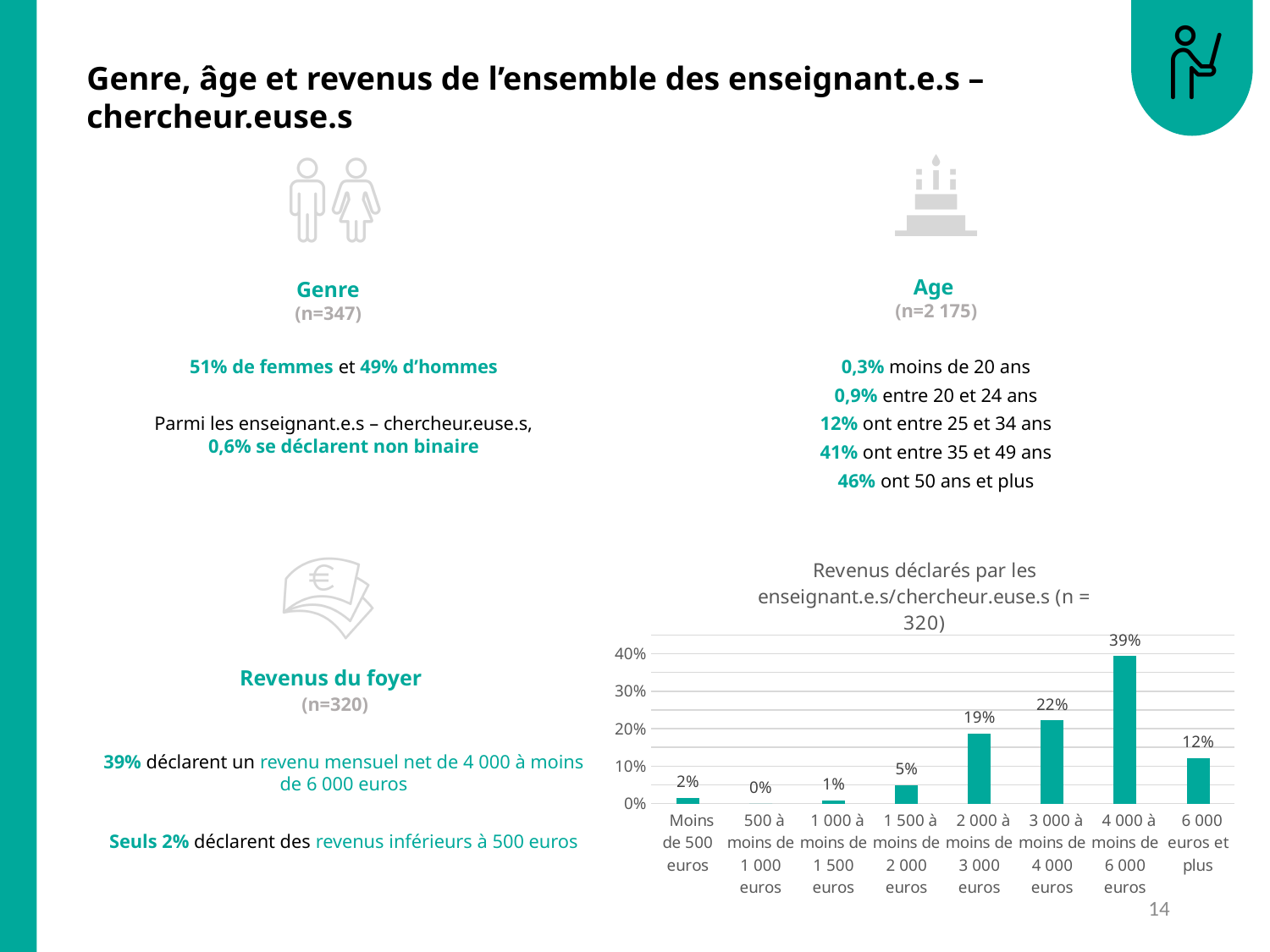
Which income category has the lowest value in the chart? 500 à moins de 1 000 euros What value does the chart show for the '4 000 à moins de 6 000 euros' category? 39% What kind of chart is used to show the declared incomes? Bar chart What value does the chart show for the 'Moins de 500 euros' category? 2% How many income categories are shown on the x axis of the chart? 8 Is the value for '2 000 à moins de 3 000 euros' greater or less than 10%? greater Which income category has the highest value in the chart? 4 000 à moins de 6 000 euros Which is larger: the value for '3 000 à moins de 4 000 euros' or the value for '6 000 euros et plus'? 3 000 à moins de 4 000 euros What value does the chart show for the '6 000 euros et plus' category? 12% What is the title of the chart on the slide? Revenus déclarés par les enseignant.e.s/chercheur.euse.s (n = 320) What value does the chart show for the '2 000 à moins de 3 000 euros' category? 19% What is the difference between the values for '4 000 à moins de 6 000 euros' and '3 000 à moins de 4 000 euros'? 17%